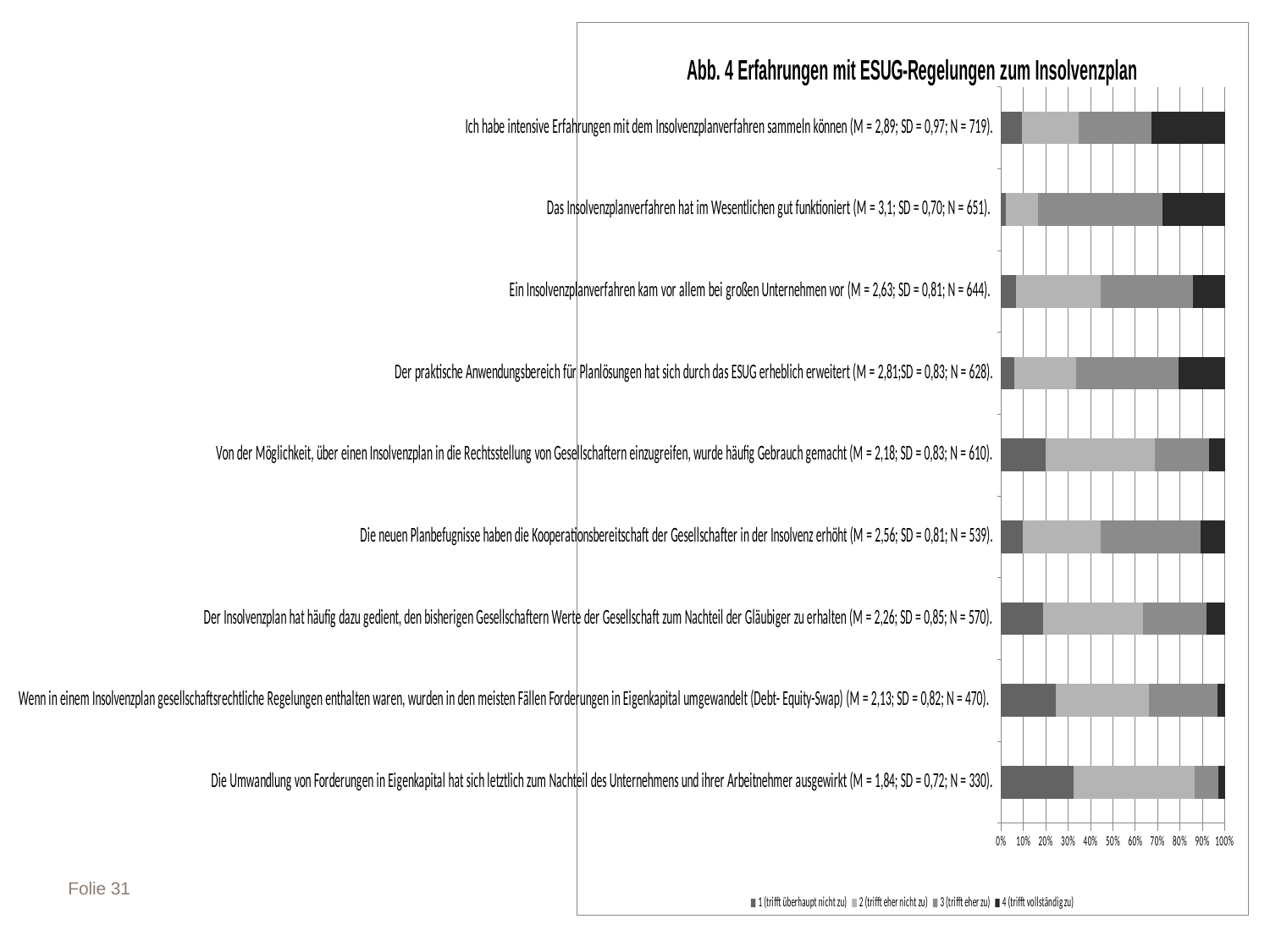
Which statement has the lowest reported mean (M)? Die Umwandlung von Forderungen in Eigenkapital hat sich letztlich zum Nachteil des Unternehmens und ihrer Arbeitnehmer ausgewirkt (M = 1,84) How many series does the legend list? 4 What is the N reported for the statement 'Die Umwandlung von Forderungen in Eigenkapital hat sich letztlich zum Nachteil des Unternehmens und ihrer Arbeitnehmer ausgewirkt'? 330 What is the title of the chart? Abb. 4 Erfahrungen mit ESUG-Regelungen zum Insolvenzplan Which statement has the largest share of '1 (trifft überhaupt nicht zu)'? Die Umwandlung von Forderungen in Eigenkapital hat sich letztlich zum Nachteil des Unternehmens und ihrer Arbeitnehmer ausgewirkt What is the legend entry for the darkest (black) series? 4 (trifft vollständig zu) Is the share of '1 (trifft überhaupt nicht zu)' for the statement 'Das Insolvenzplanverfahren hat im Wesentlichen gut funktioniert' greater or less than 10%? less Which statement has the highest reported mean (M)? Das Insolvenzplanverfahren hat im Wesentlichen gut funktioniert (M = 3,1) Is the share of '1 (trifft überhaupt nicht zu)' for the statement 'Die Umwandlung von Forderungen in Eigenkapital hat sich letztlich zum Nachteil des Unternehmens und ihrer Arbeitnehmer ausgewirkt' greater or less than 20%? greater What kind of chart is shown on the slide? Stacked bar chart How many statements (categories) are plotted in the chart? 9 What is the mean (M) reported for the statement 'Das Insolvenzplanverfahren hat im Wesentlichen gut funktioniert'? 3,1